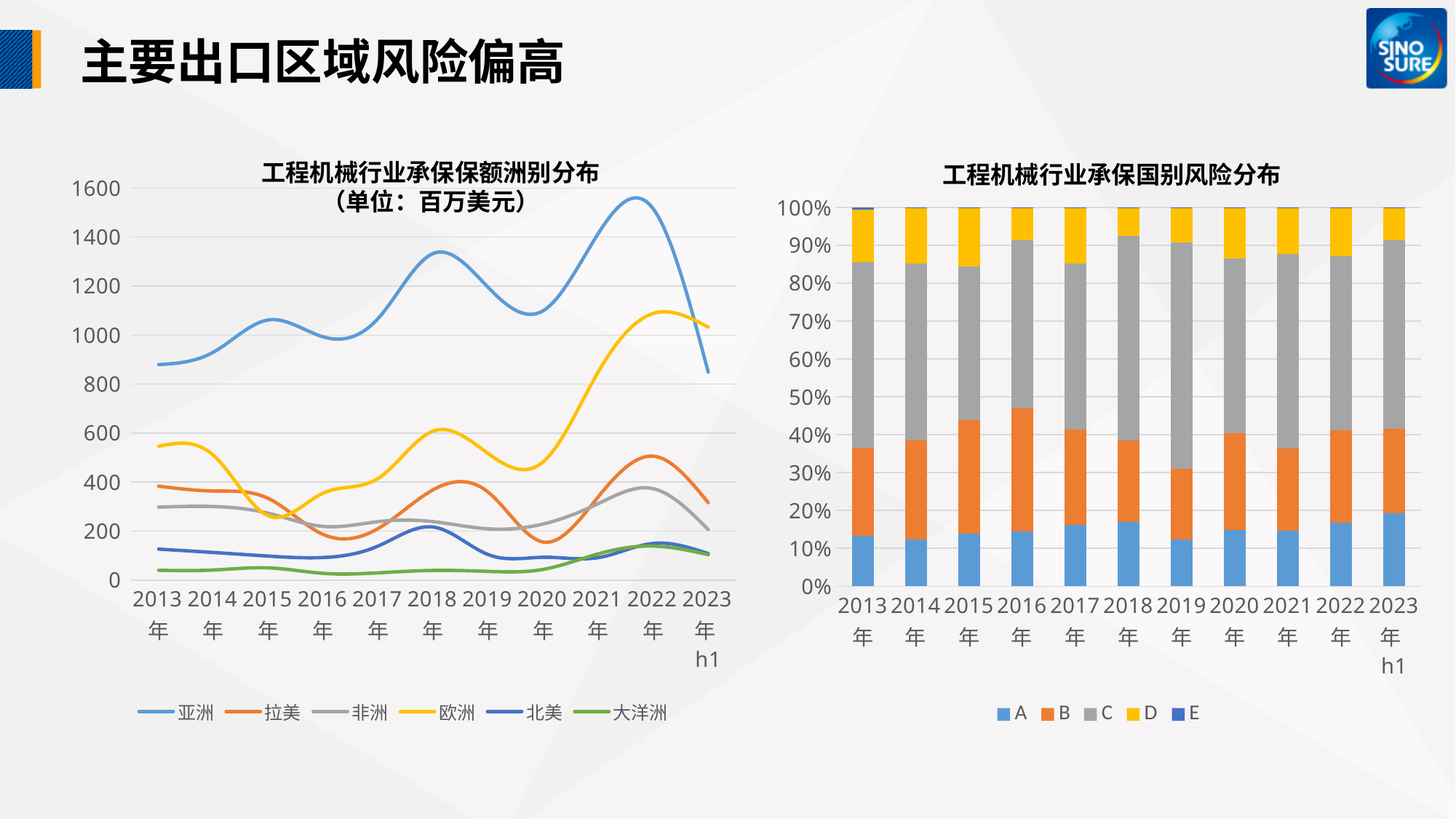
What kind of chart is the chart titled 工程机械行业承保国别风险分布? bar chart In the chart titled 工程机械行业承保保额洲别分布, which series has the lowest value in 2013年? 大洋洲 In the chart titled 工程机械行业承保国别风险分布, how many years (categories) are shown on the x axis? 11 In the chart titled 工程机械行业承保保额洲别分布, which series has the highest value in 2022年? 亚洲 In the chart titled 工程机械行业承保保额洲别分布, is the value for 亚洲 in 2022年 greater or less than 1400? greater In the chart titled 工程机械行业承保国别风险分布, which series takes the largest share in 2016年? C In the chart titled 工程机械行业承保国别风险分布, how many series does the legend list? 5 In the chart titled 工程机械行业承保保额洲别分布, is the value for 亚洲 in 2013年 greater or less than 1000? less In the chart titled 工程机械行业承保保额洲别分布, which is larger in 2022年, 欧洲 or 拉美? 欧洲 What kind of chart is the chart titled 工程机械行业承保保额洲别分布? line chart In the chart titled 工程机械行业承保保额洲别分布, how many series does the legend list? 6 What unit is stated in the title of the chart titled 工程机械行业承保保额洲别分布? 百万美元